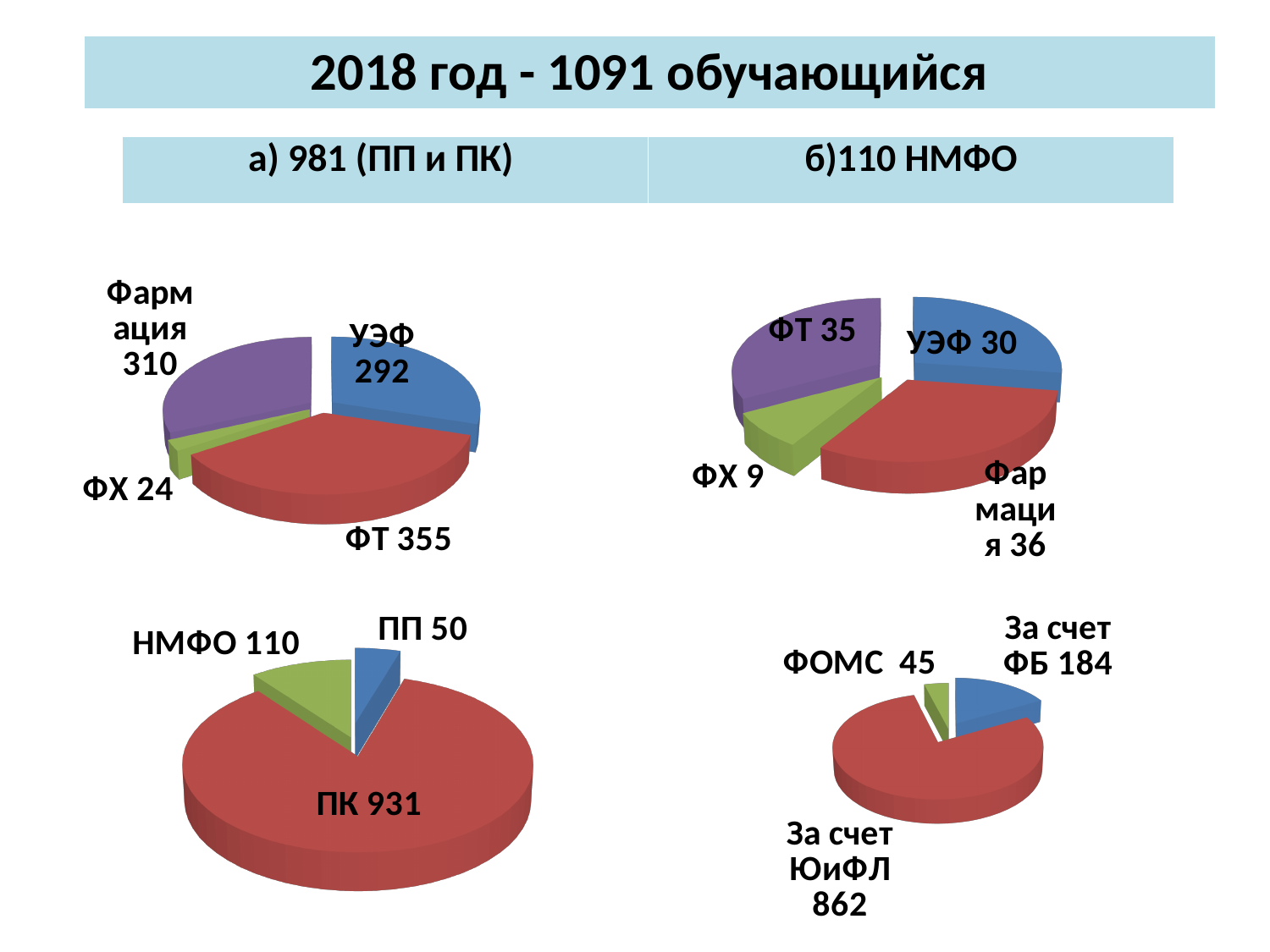
In the bottom-left pie chart, what is the value for ПК? 931 In the bottom-right pie chart, what is the value for ФОМС? 45 In the bottom-left pie chart, what is the total of all slices? 1091 In the top-left pie chart (under "а) 981 (ПП и ПК)"), what is the difference between Фармация and УЭФ? 18 In the top-right pie chart (under "б)110 НМФО"), which category has the largest value? Фармация In the top-left pie chart (under "а) 981 (ПП и ПК)"), what is the value for ФТ? 355 What type of chart is used for all four charts on the slide? Pie chart In the top-right pie chart (under "б)110 НМФО"), how many slices does the pie have? 4 In the bottom-left pie chart, which is larger, НМФО or ПП? НМФО In the bottom-right pie chart, what is the difference between За счет ЮиФЛ and За счет ФБ? 678 In the top-left pie chart (under "а) 981 (ПП и ПК)"), which category has the smallest value? ФХ In the top-right pie chart (under "б)110 НМФО"), what is the value for ФХ? 9